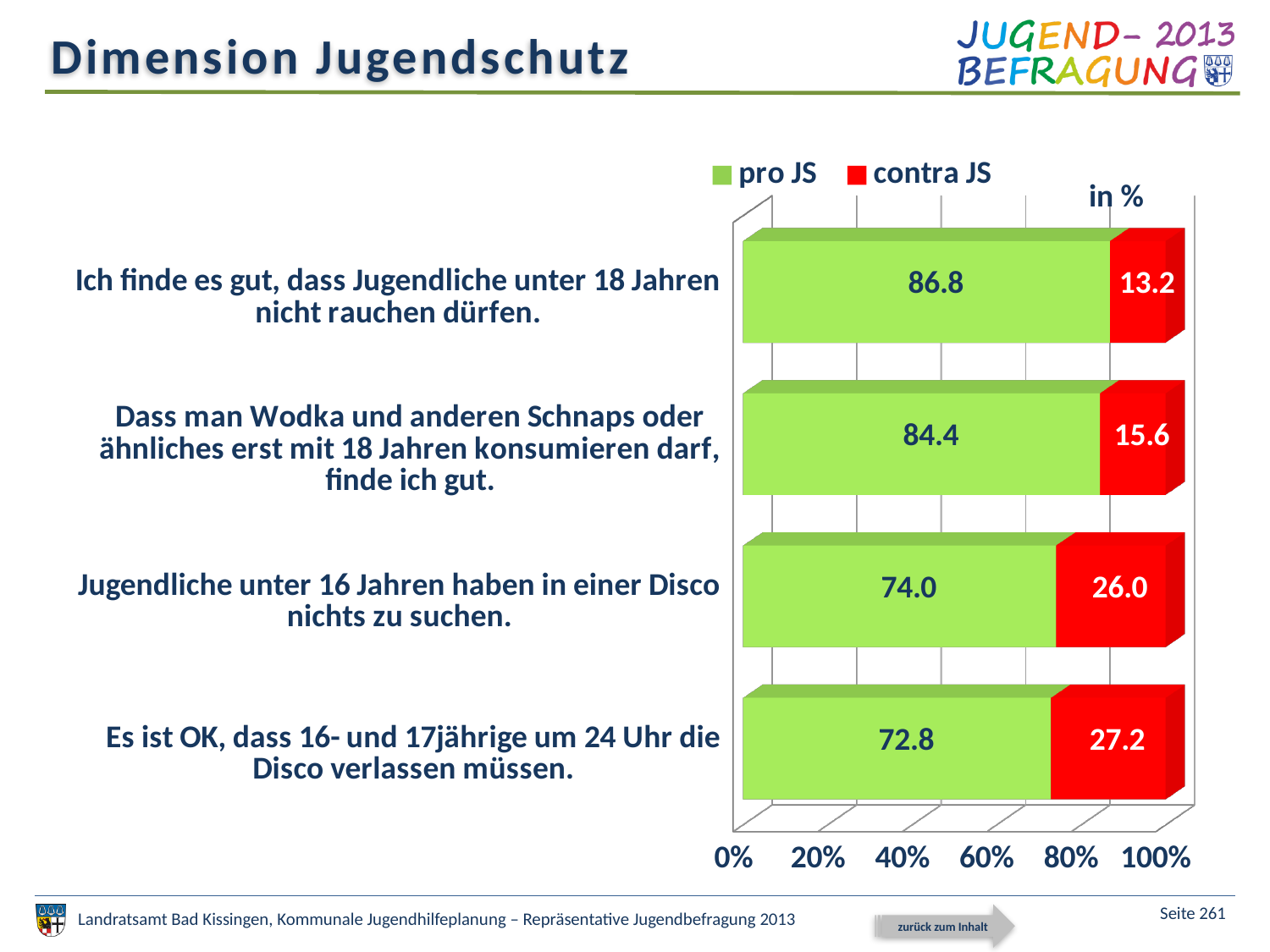
What is the 'contra JS' value for 'Jugendliche unter 16 Jahren haben in einer Disco nichts zu suchen.'? 26.0 What kind of chart is shown on the slide? Stacked bar chart How many statements (categories) are shown in the chart? 4 Which statement has the lowest 'pro JS' value? Es ist OK, dass 16- und 17jährige um 24 Uhr die Disco verlassen müssen. What is the 'pro JS' value for 'Es ist OK, dass 16- und 17jährige um 24 Uhr die Disco verlassen müssen.'? 72.8 What is the difference between the 'pro JS' values for the smoking statement (86.8) and the Disco-leaving statement (72.8)? 14.0 Which statement has the highest 'pro JS' value? Ich finde es gut, dass Jugendliche unter 18 Jahren nicht rauchen dürfen. How many series does the legend list? 2 What is the 'contra JS' value for the statement about Wodka und anderen Schnaps? 15.6 What is the 'pro JS' value for 'Ich finde es gut, dass Jugendliche unter 18 Jahren nicht rauchen dürfen.'? 86.8 Which is larger: the 'contra JS' value for the Disco under-16 statement or for the Wodka statement? Disco under-16 statement (26.0) What is the total of the stacked bar for 'Jugendliche unter 16 Jahren haben in einer Disco nichts zu suchen.'? 100.0